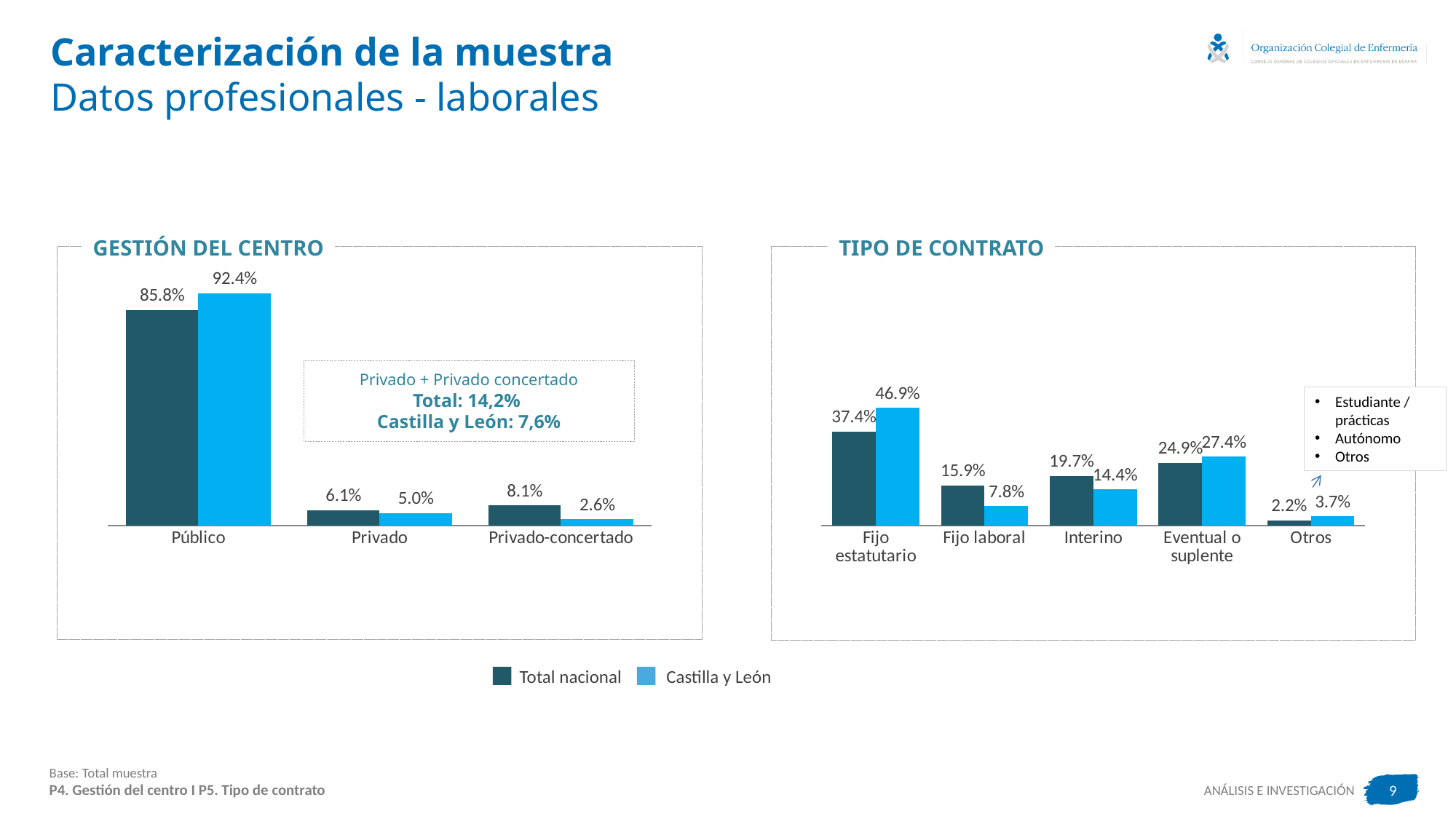
In the GESTIÓN DEL CENTRO chart, what is the difference between the Castilla y León and Total nacional values for Público? 6.6% In the GESTIÓN DEL CENTRO chart, which category has the highest Total nacional value? Público In the GESTIÓN DEL CENTRO chart, how many categories are shown on the x axis? 3 In the TIPO DE CONTRATO chart, which category has the lowest Castilla y León value? Otros What kind of chart is the TIPO DE CONTRATO chart? Bar chart How many series does the legend list? 2 In the TIPO DE CONTRATO chart, what is the Castilla y León value for Fijo estatutario? 46.9% In the TIPO DE CONTRATO chart, what is the difference between the Total nacional and Castilla y León values for Fijo laboral? 8.1% In the TIPO DE CONTRATO chart, which is larger for Eventual o suplente: Total nacional or Castilla y León? Castilla y León In the GESTIÓN DEL CENTRO chart, what is the Castilla y León value for Público? 92.4% In the TIPO DE CONTRATO chart, what is the Total nacional value for Interino? 19.7% In the GESTIÓN DEL CENTRO chart, what is the Total nacional value for Privado-concertado? 8.1%